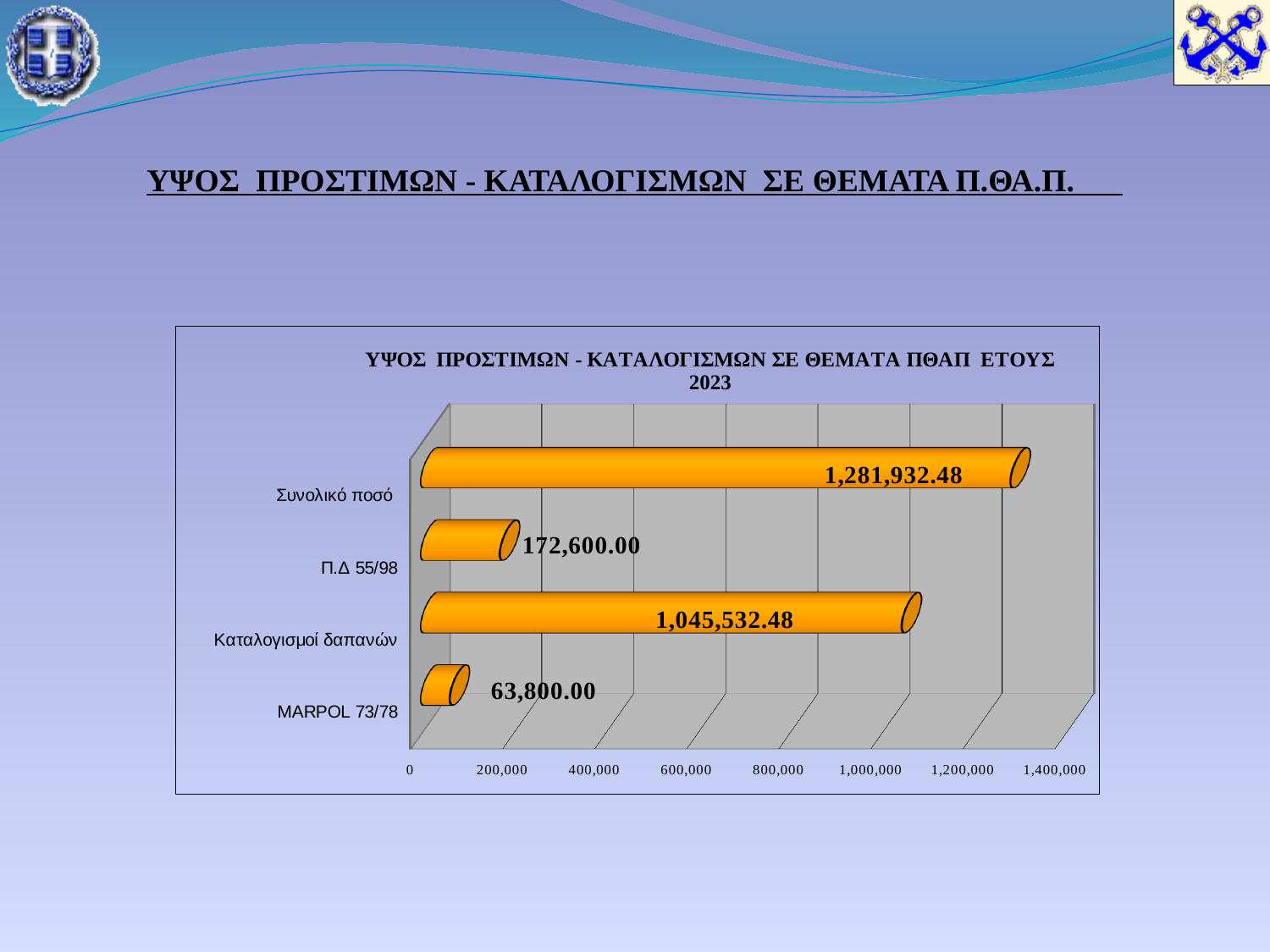
What is the difference between the values for Π.Δ 55/98 and MARPOL 73/78? 108,800.00 How many categories are shown in the chart? 4 Which category has the lowest value? MARPOL 73/78 What is the difference between the values for Συνολικό ποσό and Καταλογισμοί δαπανών? 236,400.00 What is the value for Π.Δ 55/98? 172,600.00 Is the value for Καταλογισμοί δαπανών greater or less than 1,000,000? greater What is the value for MARPOL 73/78? 63,800.00 What type of chart is shown on the slide? Bar chart Which is larger, the value for Π.Δ 55/98 or the value for MARPOL 73/78? Π.Δ 55/98 Which category has the highest value? Συνολικό ποσό What is the value for Καταλογισμοί δαπανών? 1,045,532.48 What is the value for Συνολικό ποσό? 1,281,932.48